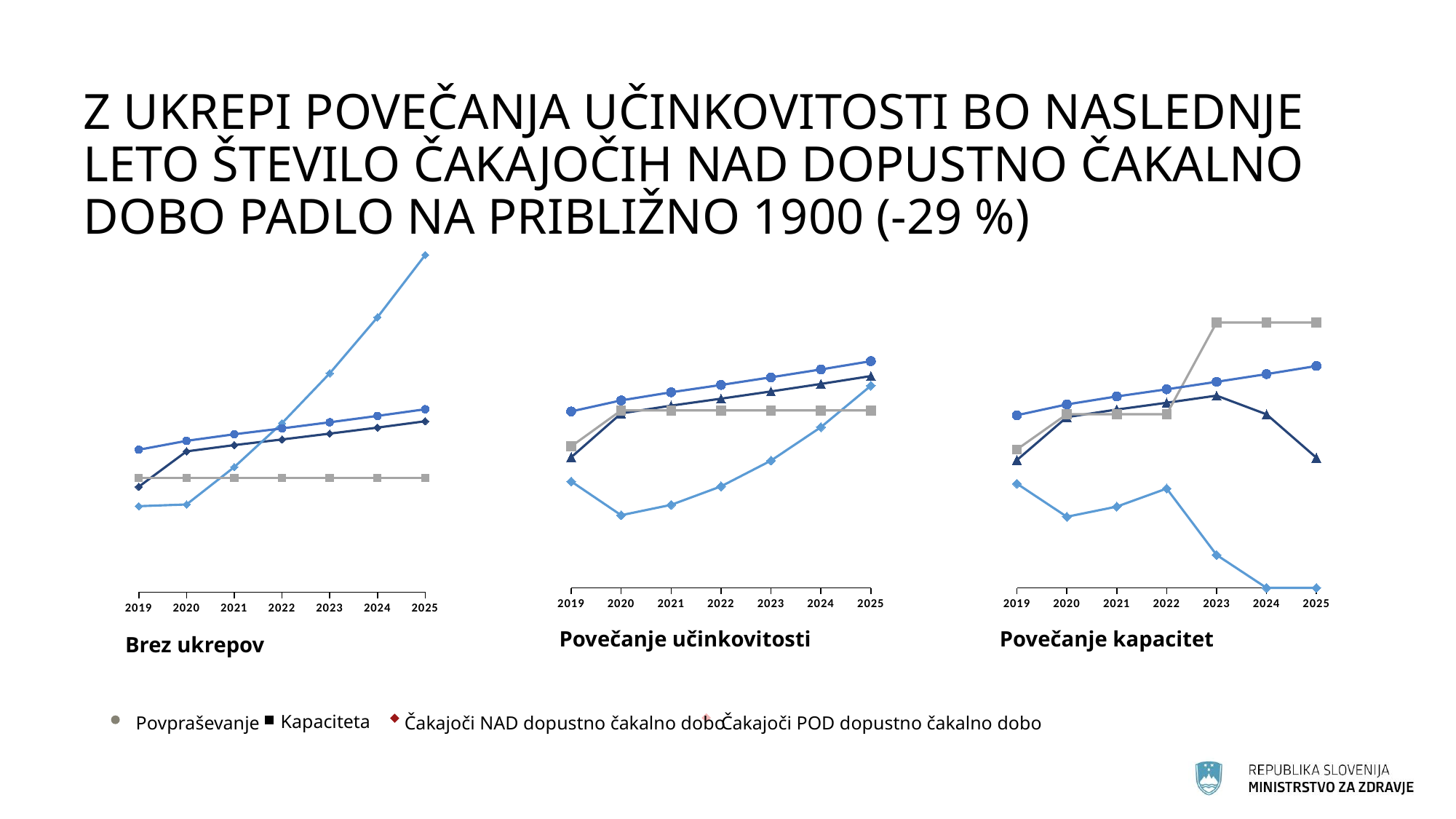
In the "Povečanje kapacitet" chart, which series has the highest value in 2025? Kapaciteta In the "Brez ukrepov" chart, does the Kapaciteta line rise, fall or stay flat from 2019 to 2025? stay flat In the "Povečanje kapacitet" chart, does the Čakajoči NAD dopustno čakalno dobo line rise or fall from 2022 to 2025? fall What is the title of the chart on the right of the slide? Povečanje kapacitet How many years are shown on the x axis of the "Povečanje učinkovitosti" chart? 7 How many series does the legend list? 4 What is the first series listed in the legend? Povpraševanje In the "Povečanje učinkovitosti" chart, is the Povpraševanje value in 2025 higher or lower than the Kapaciteta value in 2025? higher In the "Brez ukrepov" chart, which series has the highest value in 2025? Čakajoči NAD dopustno čakalno dobo In the "Brez ukrepov" chart, does the Čakajoči NAD dopustno čakalno dobo line rise or fall from 2020 to 2025? rise In the "Povečanje kapacitet" chart, which series has the lowest value in 2025? Čakajoči NAD dopustno čakalno dobo What kind of chart is the "Brez ukrepov" chart? line chart